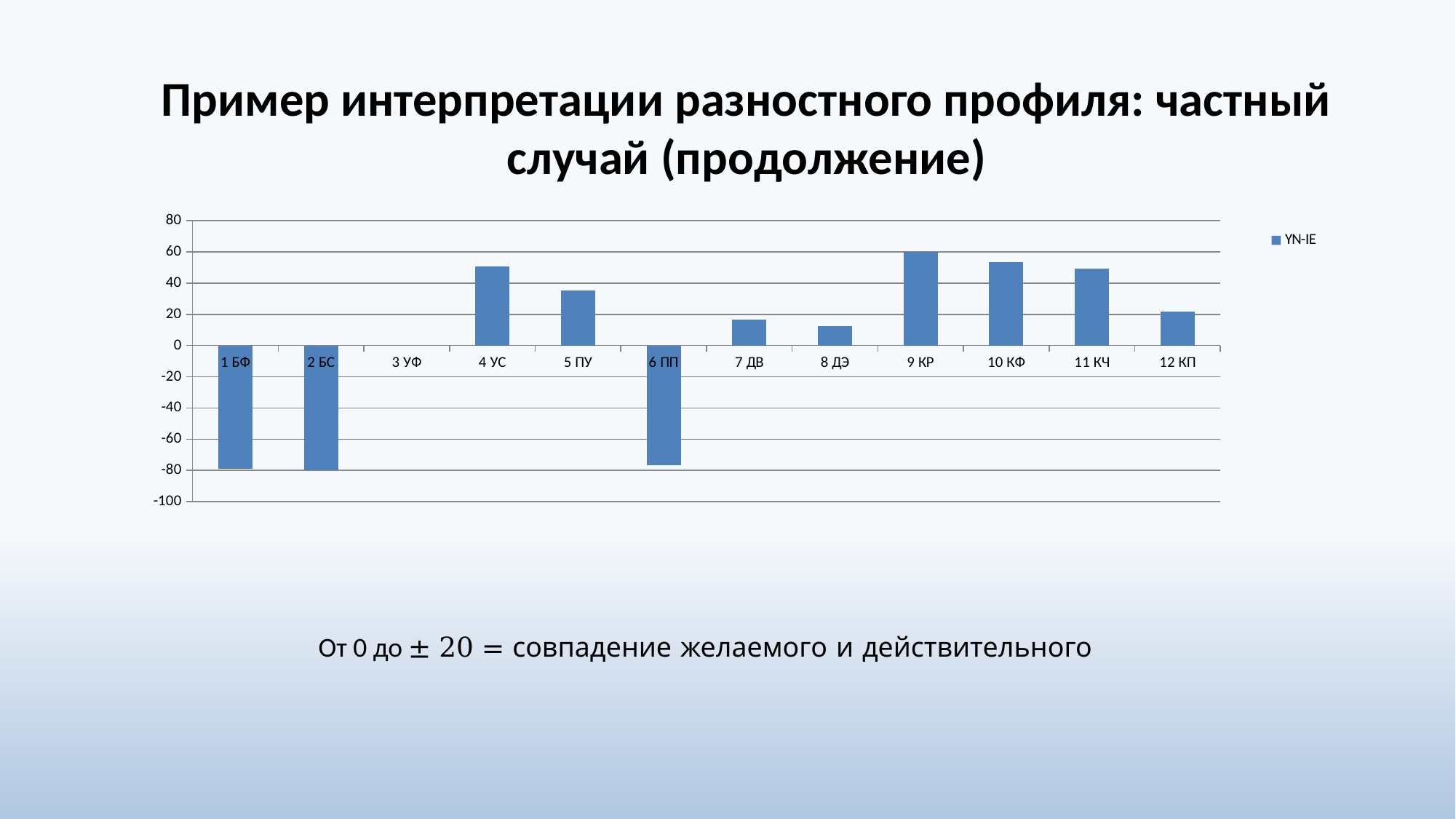
Is the value for 4 УС greater or less than 40? greater Is the value for 1 БФ greater or less than -60? less Which category has the highest value in the chart? 9 КР What is the name of the series shown in the chart legend? YN-IE Which has the larger value, 4 УС or 5 ПУ? 4 УС How many categories are shown on the x axis of the chart? 12 How many series does the chart legend list? 1 Is the value for 5 ПУ greater or less than 40? less Which has the larger value, 9 КР or 10 КФ? 9 КР What kind of chart is shown on the slide? bar chart